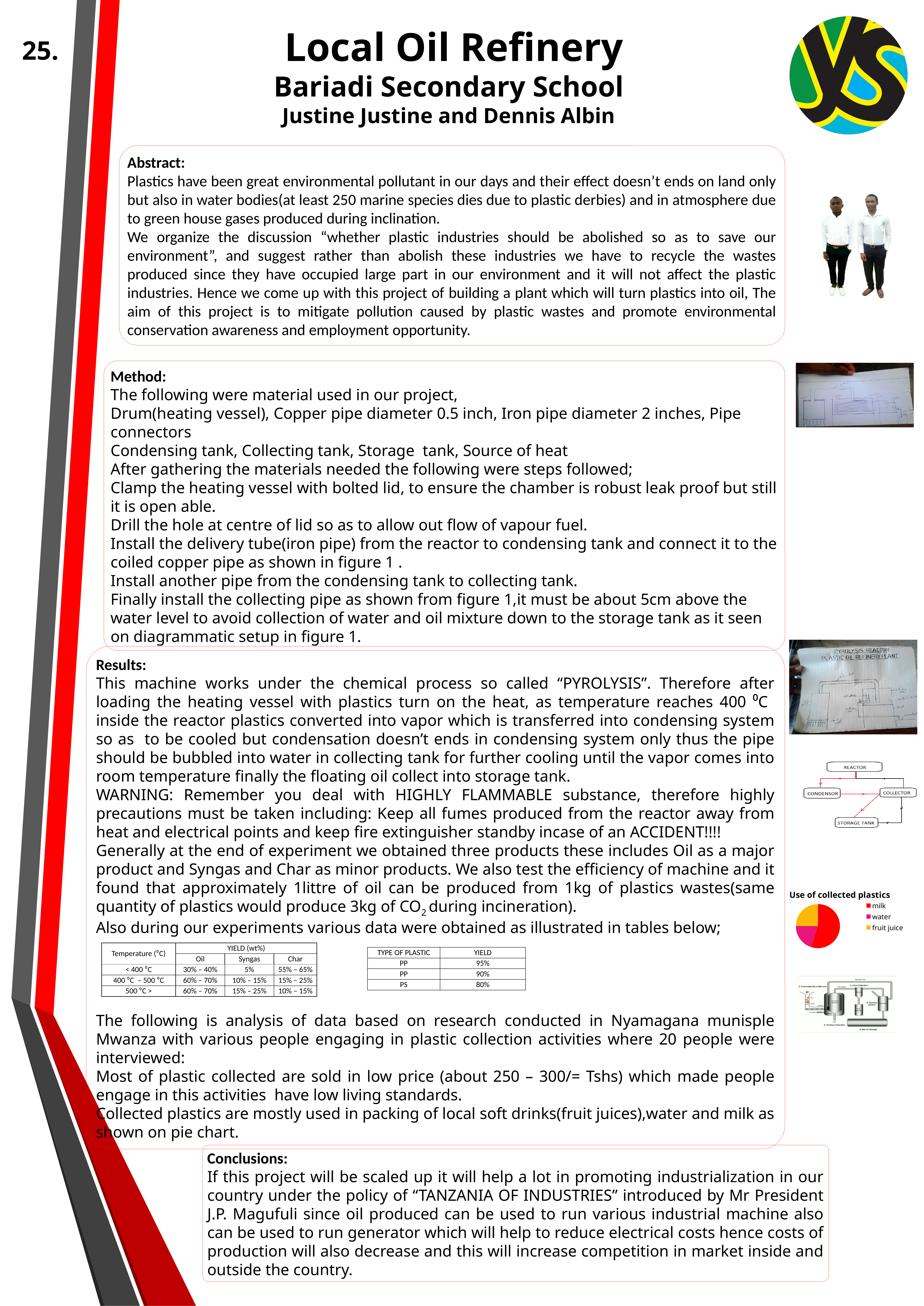
What kind of chart is the 'Use of collected plastics' chart? pie chart How many slices does the 'Use of collected plastics' pie chart have? 3 In the 'Use of collected plastics' pie chart, which slice is larger: milk or fruit juice? milk What is the title of the pie chart on the slide? Use of collected plastics In the 'Use of collected plastics' pie chart, which slice is larger: milk or water? milk In the 'Use of collected plastics' pie chart, which category has the largest slice? milk How many categories does the legend of the 'Use of collected plastics' pie chart list? 3 In the 'Use of collected plastics' pie chart, which colour represents milk? red